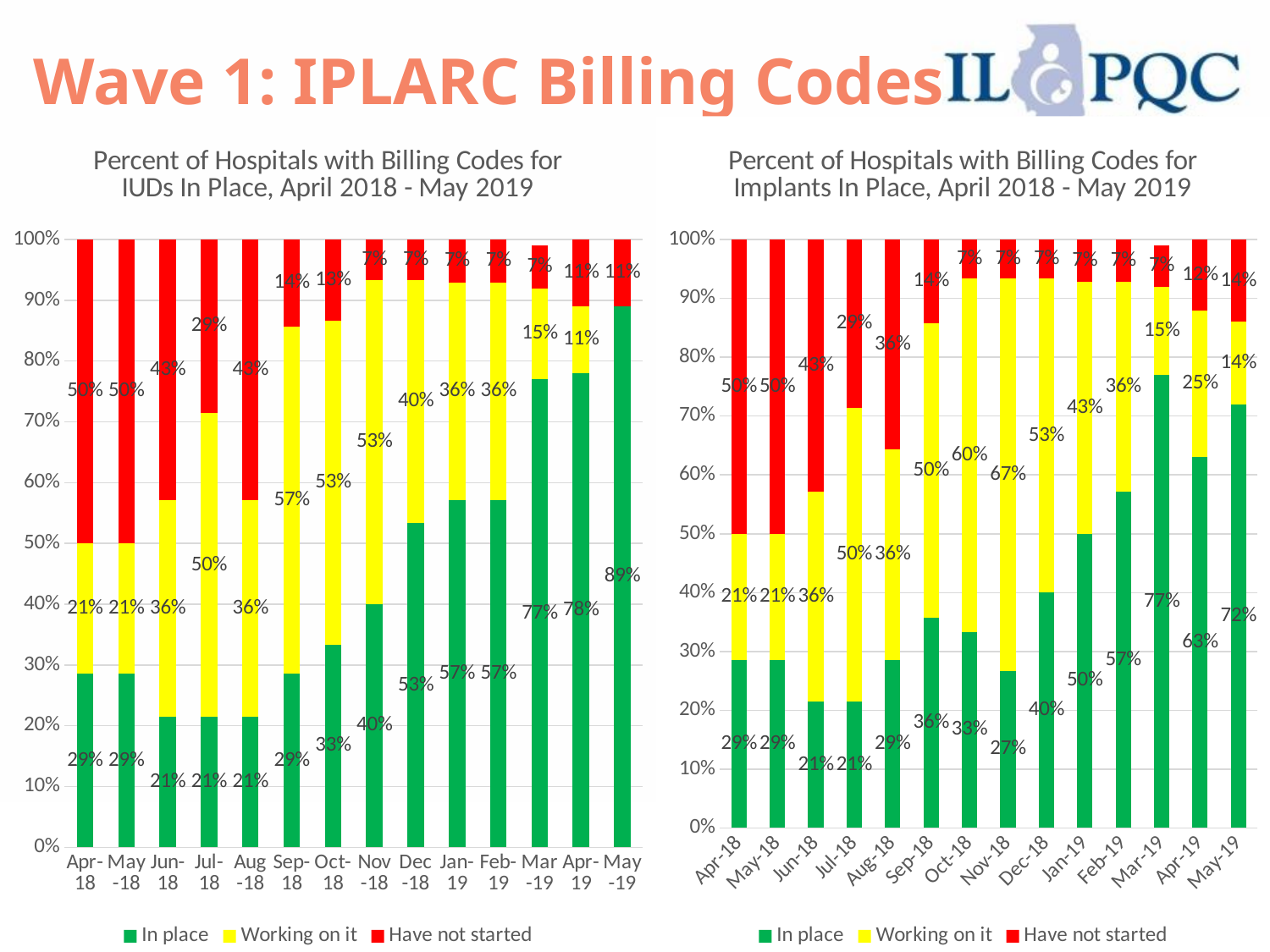
In the left chart (IUDs In Place), what is the 'Have not started' value for Apr-18? 50% In the left chart (IUDs In Place), does the 'In place' value generally rise or fall from Apr-18 to May-19? Rise In the left chart (IUDs In Place), what is the difference between the 'In place' values for May-19 and Apr-19? 11% In the right chart (Implants In Place), what is the 'In place' value for Apr-19? 63% In the right chart (Implants In Place), which month has the highest 'In place' value? Mar-19 How many series does the legend of the right chart (Implants In Place) list? 3 In the right chart (Implants In Place), which is larger: the 'In place' value for Apr-19 or for May-19? May-19 In the left chart (IUDs In Place), what percent of hospitals had billing codes 'In place' in May-19? 89% In the right chart (Implants In Place), what is the 'Working on it' value for Nov-18? 67% How many months are shown on the x axis of the left chart (IUDs In Place)? 14 In the left chart (IUDs In Place), which month has the highest 'In place' value? May-19 What kind of chart is the left chart (IUDs In Place)? Stacked bar chart